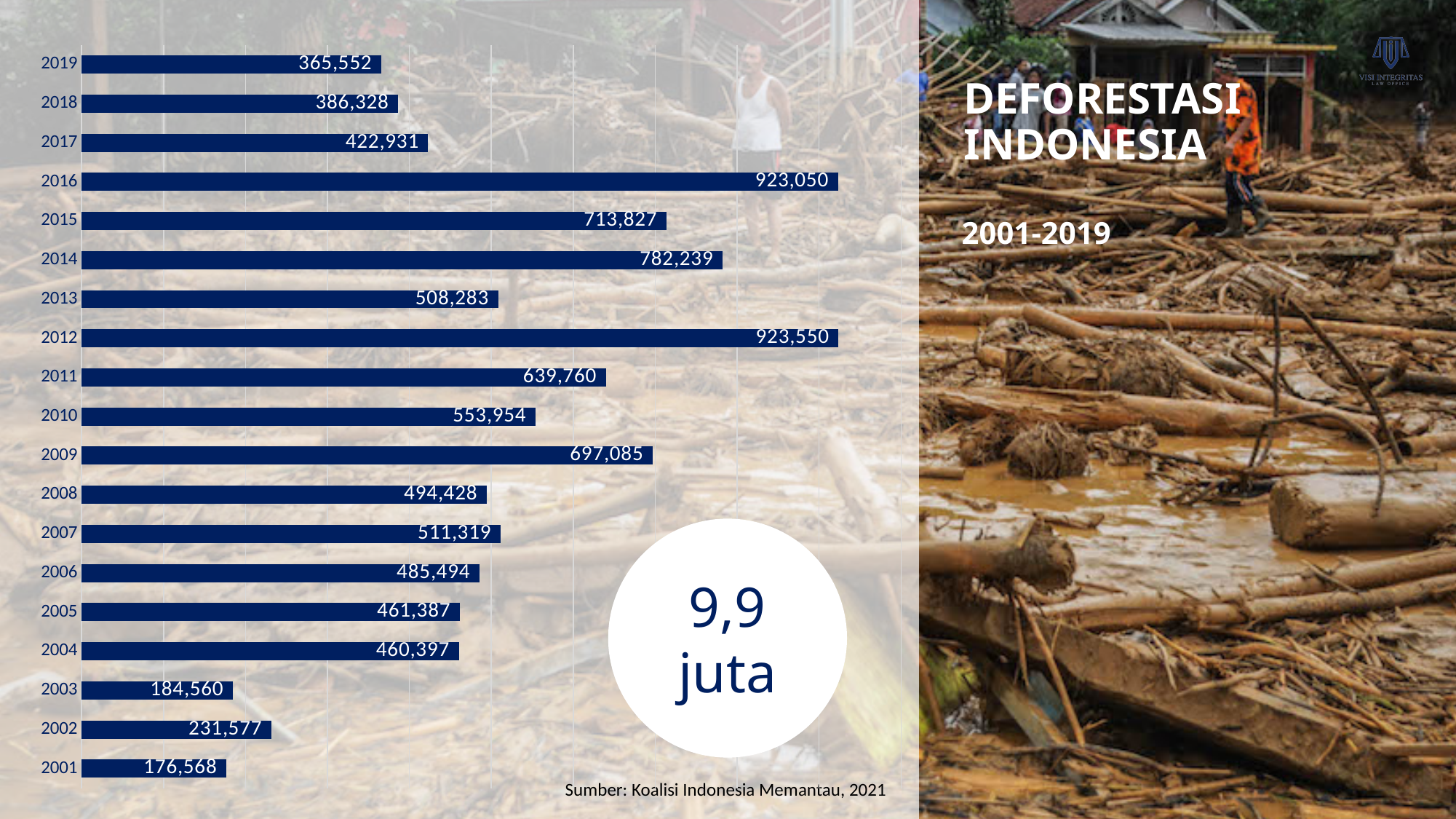
Do the values rise or fall from 2017 to 2019? Fall What value is labelled on the bar for 2001? 176,568 Which year has the larger value, 2003 or 2002? 2002 Which year has the larger value, 2015 or 2014? 2014 Which year has the lowest value in the chart? 2001 What is the value shown for 2012? 923,550 What is the difference between the values for 2014 and 2015? 68,412 What is the difference between the values for 2016 and 2017? 500,119 What kind of chart is shown on the slide? Bar chart What value is shown for 2009? 697,085 What is the deforestation value shown for 2016? 923,050 How many years are shown in the chart? 19